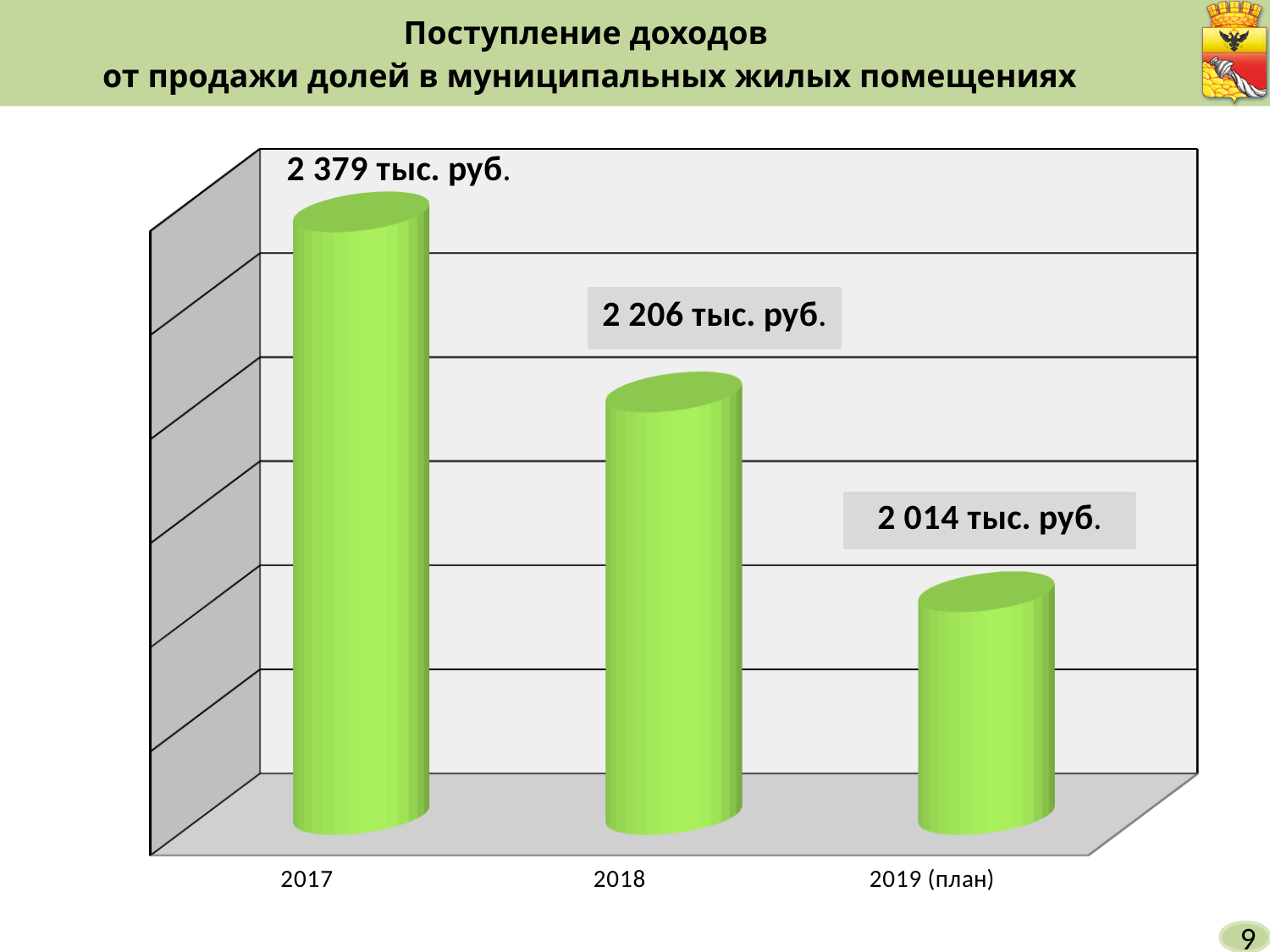
What is the difference between the values for 2018 and 2019 (план)? 192 тыс. руб. What is the difference between the values for 2017 and 2018? 173 тыс. руб. What is the value for 2019 (план)? 2 014 тыс. руб. Which is larger, the value for 2018 or the value for 2019 (план)? 2018 Which year has the lowest value? 2019 (план) What is the difference between the values for 2017 and 2019 (план)? 365 тыс. руб. Which year has the highest value? 2017 What is the value for 2017? 2 379 тыс. руб. What kind of chart is shown on the slide? Bar chart How many categories are shown on the x axis? 3 Do the values rise or fall from 2017 to 2019 (план)? Fall What is the value for 2018? 2 206 тыс. руб.